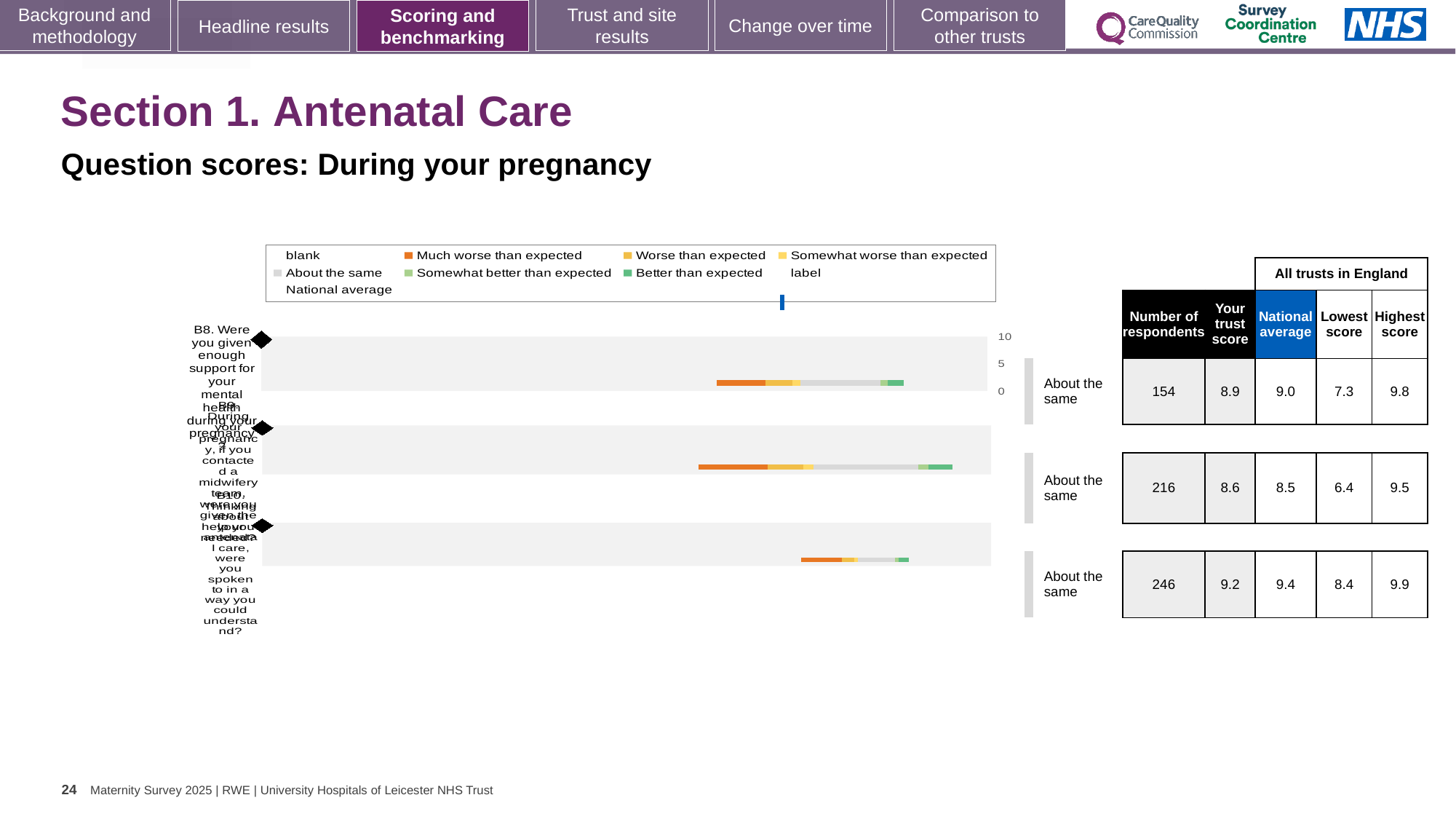
What is the lowest score among all trusts in England for the second (middle) question bar? 6.4 What is the highest score among all trusts in England for the third (bottom) question bar? 9.9 How many question bars are plotted in the chart? 3 What is the difference between the highest score and the lowest score for question B8? 2.5 What benchmark category is shown for question B8 (support for your mental health during your pregnancy)? About the same Which of the three question bars has the highest number of respondents? The third (bottom) bar, with 246 What is the trust score for question B8 (support for your mental health during your pregnancy)? 8.9 What is the number of respondents for question B8 (support for your mental health during your pregnancy)? 154 What kind of chart is shown on the slide? Bar chart For the second (middle) question bar, which is larger: the trust score or the national average? The trust score (8.6) Which legend entry is shown in orange? Much worse than expected What is the national average for question B8 (support for your mental health during your pregnancy)? 9.0